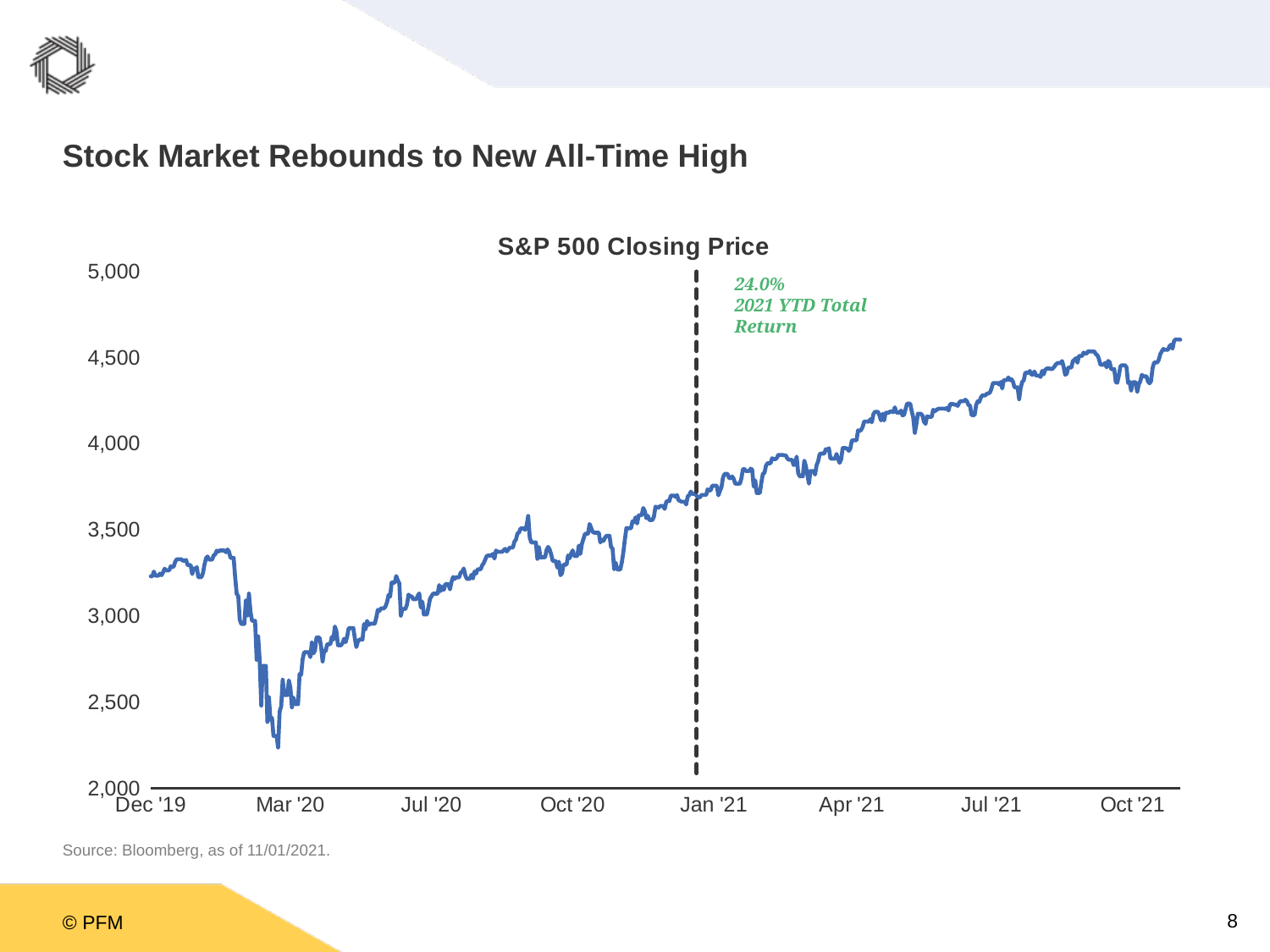
Is the S&P 500 closing price at the end of the series (after Oct '21) greater or less than 4,500? greater Is the lowest S&P 500 closing price shown in March 2020 greater or less than 2,500? less Is the S&P 500 closing price at Jan '21 greater or less than 4,000? less What kind of chart is shown on the slide? Line chart What is the title of the chart? S&P 500 Closing Price What 2021 YTD total return is annotated on the chart? 24.0% Which is higher, the S&P 500 closing price at Dec '19 or at Oct '21? Oct '21 At which x-axis label is the vertical dashed line placed? Jan '21 Overall, does the S&P 500 closing price rise or fall from Jan '21 to Oct '21? rise Around which x-axis label does the S&P 500 closing price reach its lowest point? Mar '20 How many date labels are shown on the x axis? 8